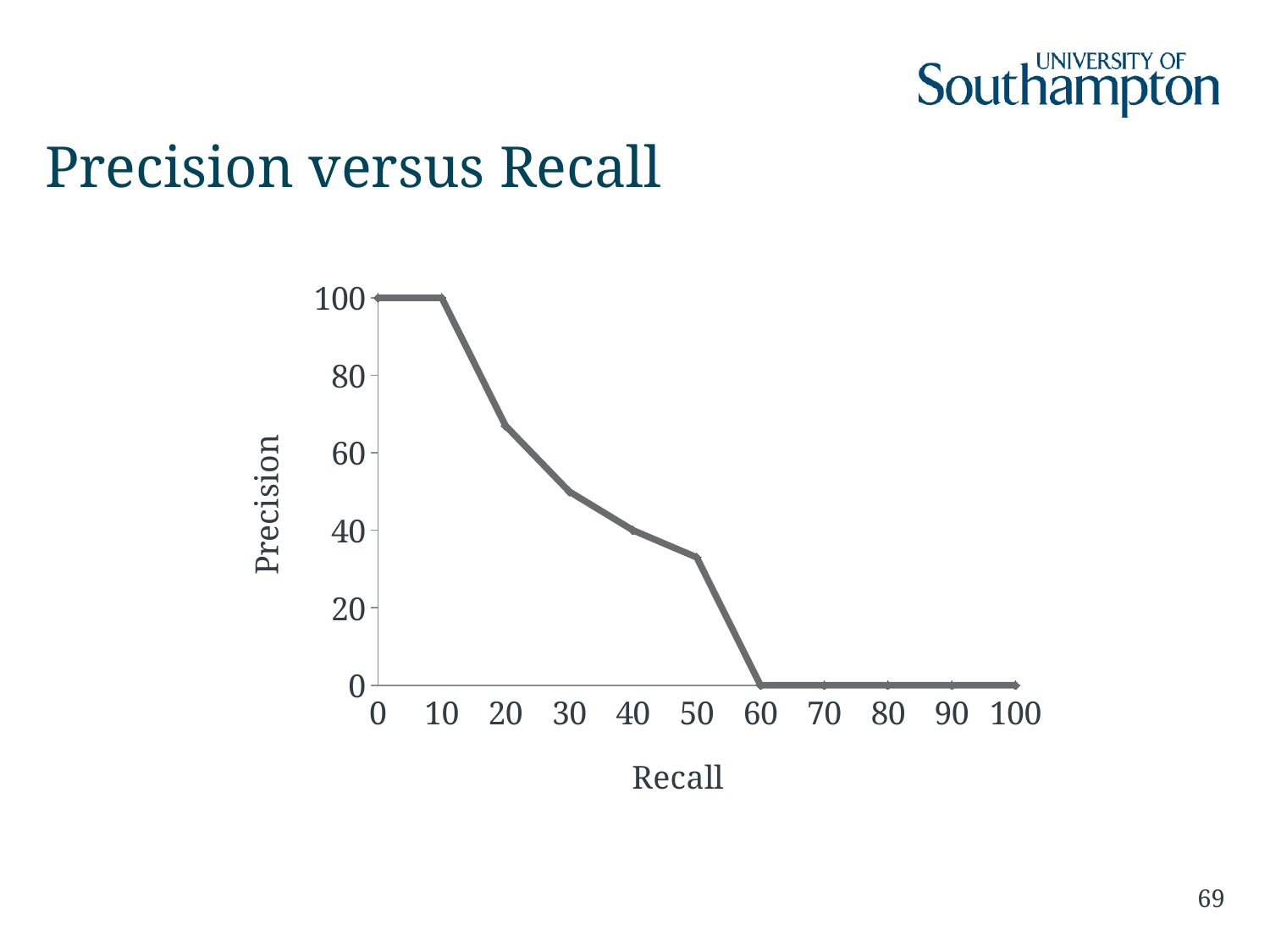
Does precision rise or fall as recall increases along the x axis? fall What is the precision value at a recall of 60? 0 What is the difference between the precision at a recall of 10 and the precision at a recall of 40? 60 What kind of chart is shown on the slide? line chart What is the precision value at a recall of 10? 100 How many data points are plotted on the line? 11 What is the precision value at a recall of 100? 0 Is the precision value at a recall of 50 greater or less than 20? greater Which has the higher precision: a recall of 20 or a recall of 40? recall of 20 What is the precision value at a recall of 40? 40 Is the precision value at a recall of 30 greater or less than 60? less Is the precision value at a recall of 20 greater or less than 60? greater